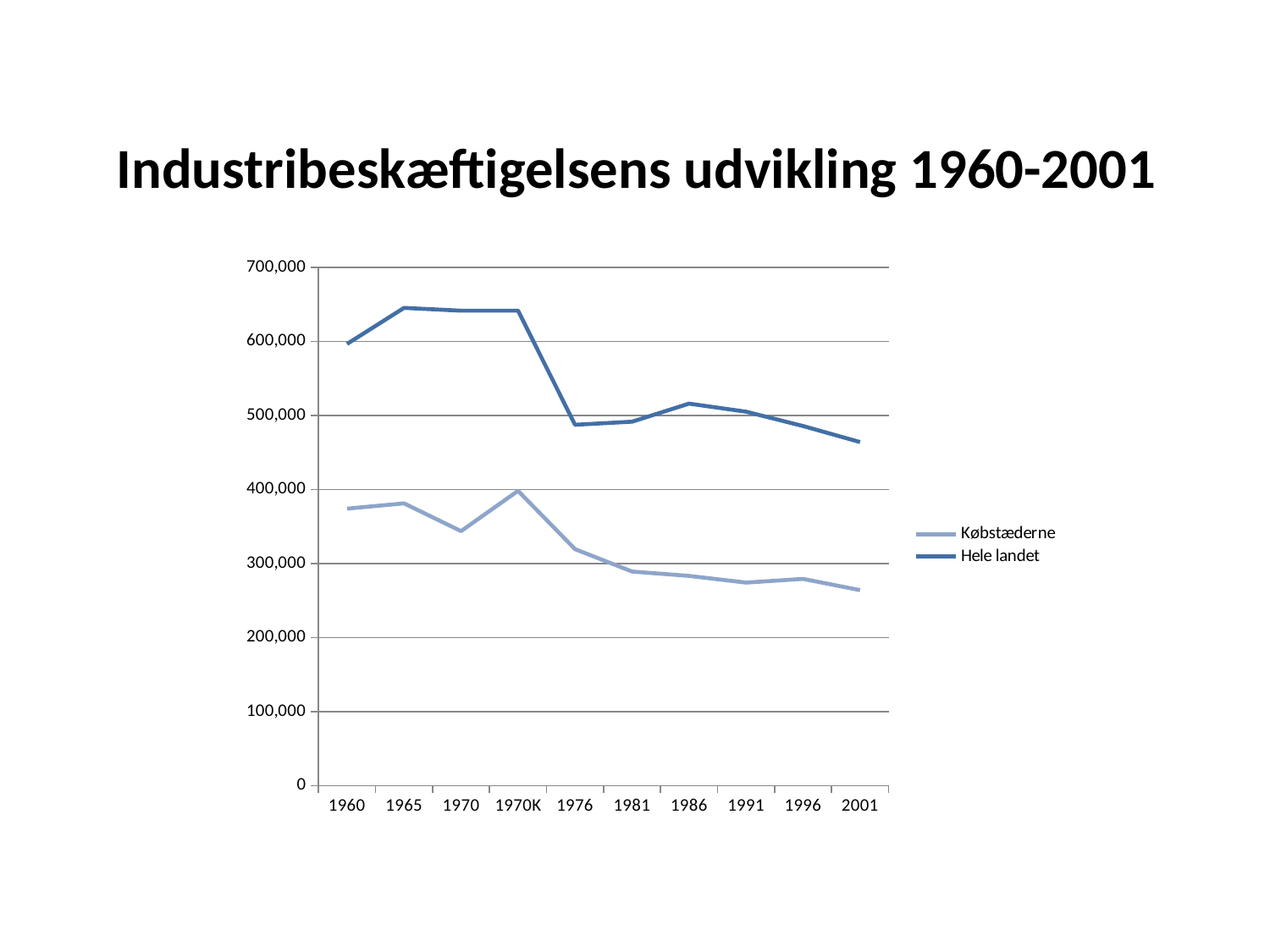
What kind of chart is shown on the slide? line chart Is the value for Købstæderne in 1981 greater or less than 300,000? less Which series has the larger value in 1986, Købstæderne or Hele landet? Hele landet Does the Hele landet series overall rise or fall from 1960 to 2001? fall How many points are plotted along the x axis for each series? 10 In which year does the Hele landet series reach its lowest value? 2001 Which series is drawn with the darker blue line? Hele landet Is the value for Hele landet in 1960 greater or less than 500,000? greater What is the title of the chart? Industribeskæftigelsens udvikling 1960-2001 In which year does the Købstæderne series reach its highest value? 1970K Is the value for Hele landet in 2001 greater or less than 500,000? less How many series does the legend list? 2